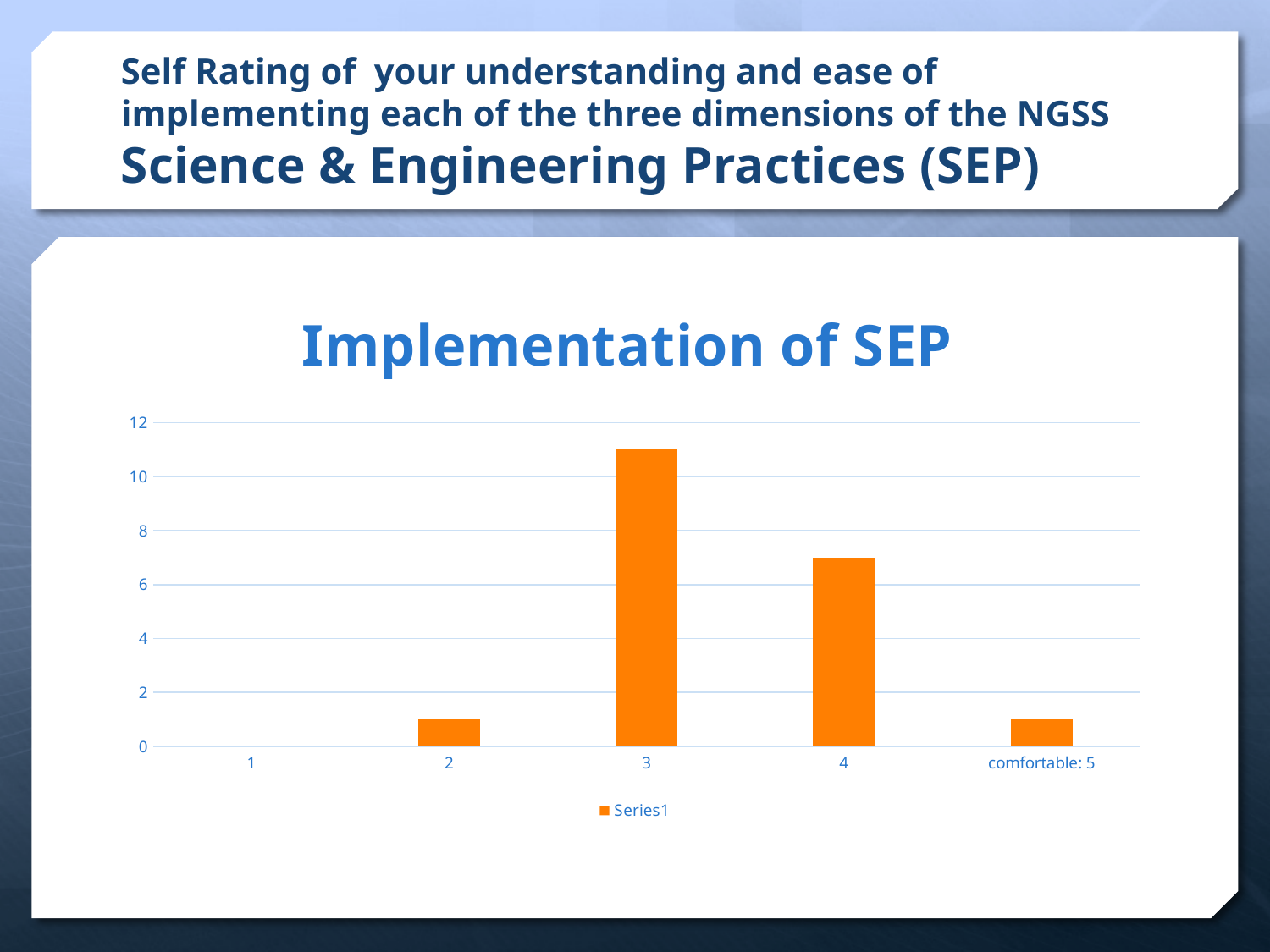
What type of chart is shown on the slide? bar chart How many series does the legend list? 1 What is the title of the chart? Implementation of SEP Which has the larger value, category 3 or category 4? 3 Is the value for category 2 greater or less than 2? less Is the value for category 3 greater or less than 10? greater Is the value for category 4 greater or less than 6? greater Which category has the lowest value in the chart? 1 How many categories are shown on the x axis of the chart? 5 Which category has the highest value in the chart? 3 What is the name of the series shown in the legend? Series1